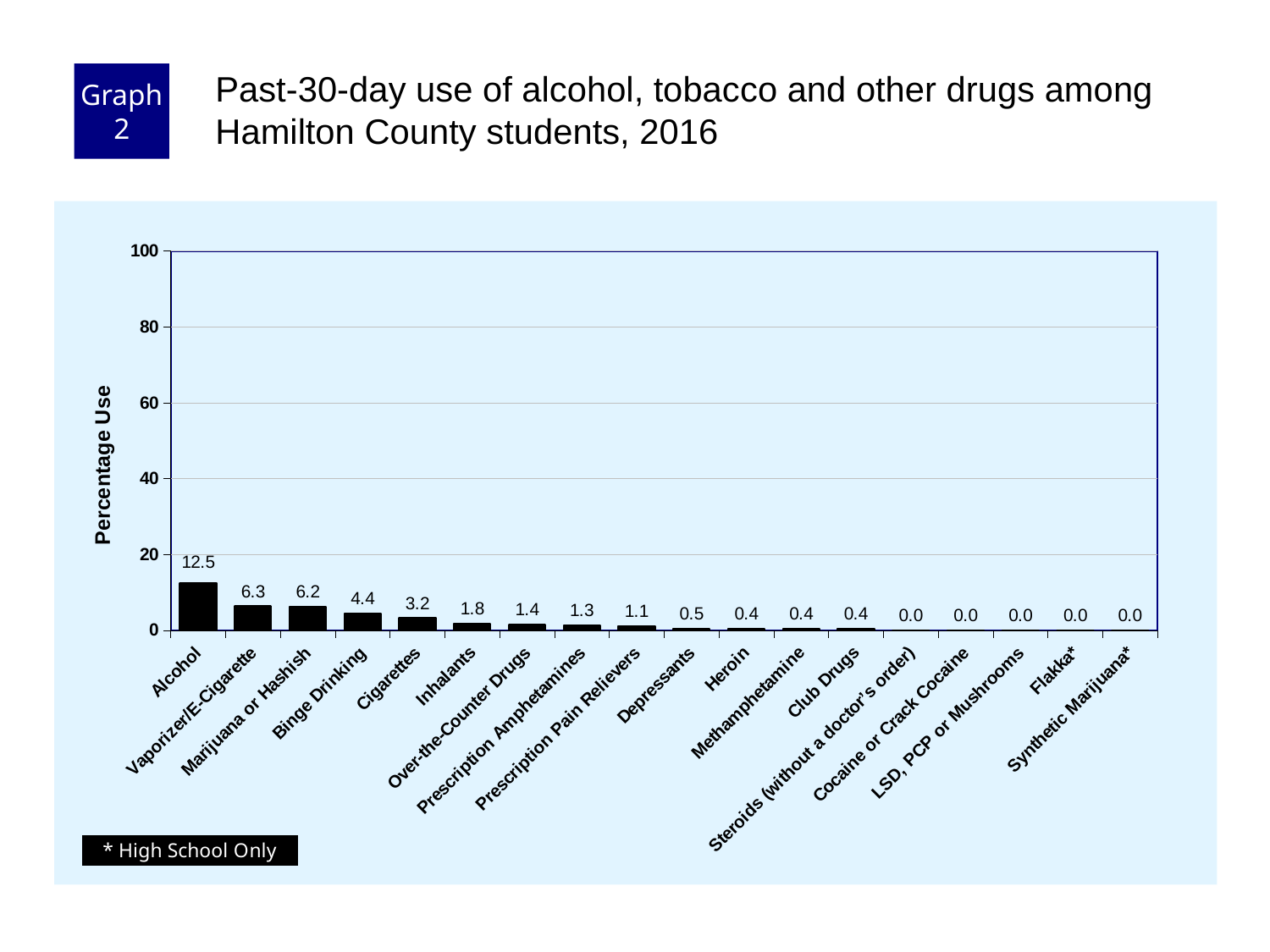
Which category has the highest percentage use? Alcohol What is the percentage use for Alcohol? 12.5 What is the label of the y axis? Percentage Use What is the difference in percentage use between Vaporizer/E-Cigarette and Marijuana or Hashish? 0.1 Which has a higher percentage use, Binge Drinking or Cigarettes? Binge Drinking What kind of chart is shown on the slide? bar chart What is the percentage use for Binge Drinking? 4.4 Is the value for Alcohol greater or less than 20? less What is the difference in percentage use between Alcohol and Cigarettes? 9.3 Do the values rise or fall moving left to right along the x axis? fall How many categories are shown on the x axis? 18 What is the percentage use for Inhalants? 1.8